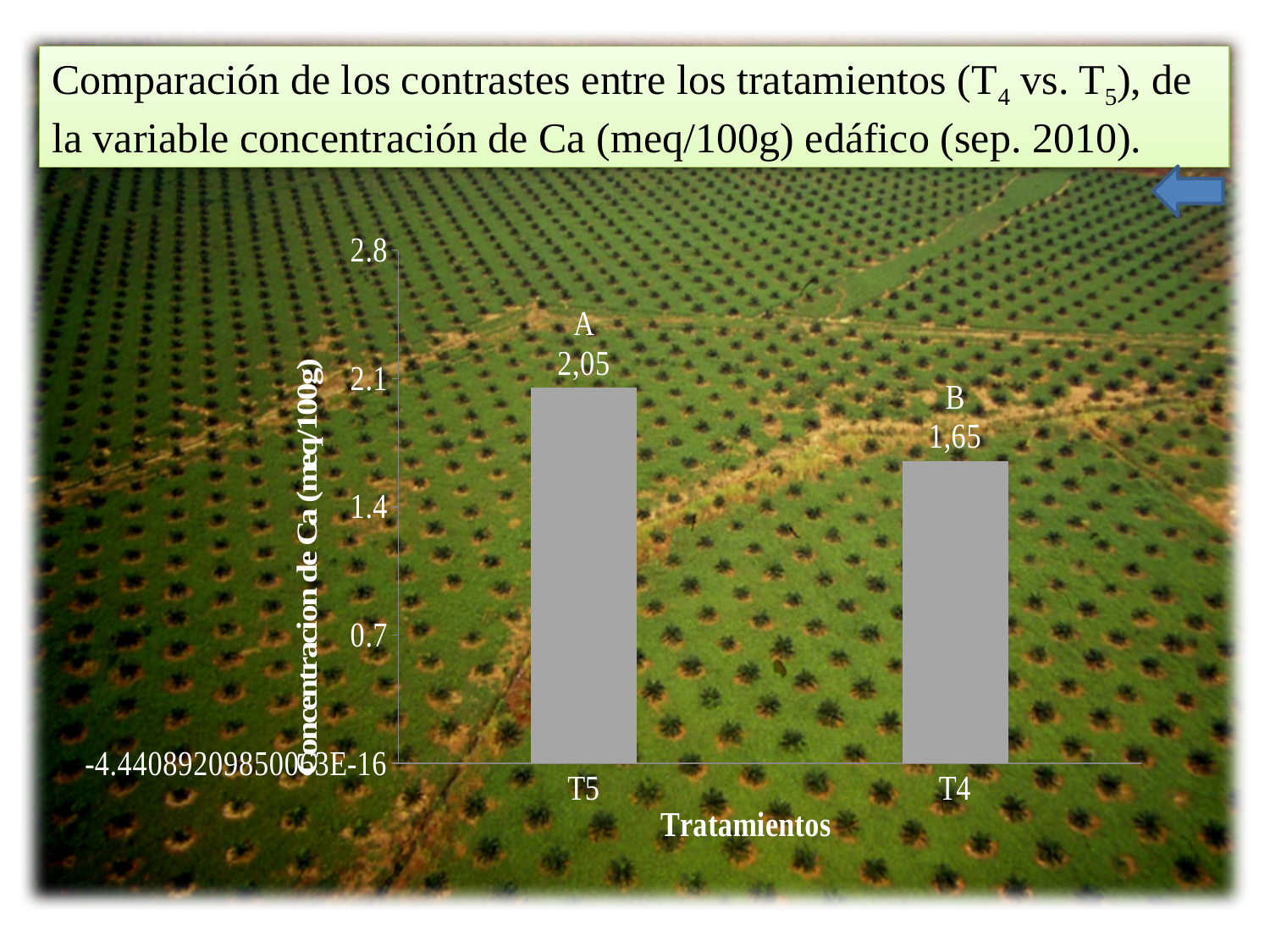
What is the Ca concentration value shown for treatment T4? 1,65 Which treatment has the lowest Ca concentration? T4 What is the Ca concentration value shown for treatment T5? 2,05 Which treatment has the highest Ca concentration? T5 How many treatments are plotted in the chart? 2 Is the value for T5 greater or less than 1.4? greater What is the label of the x axis? Tratamientos Is the value for T4 greater or less than 2.1? less Which treatment has a larger Ca concentration, T4 or T5? T5 What kind of chart is shown on the slide? bar chart What letter is printed above the bar for T4? B What is the difference between the Ca concentration values for T5 and T4? 0,40